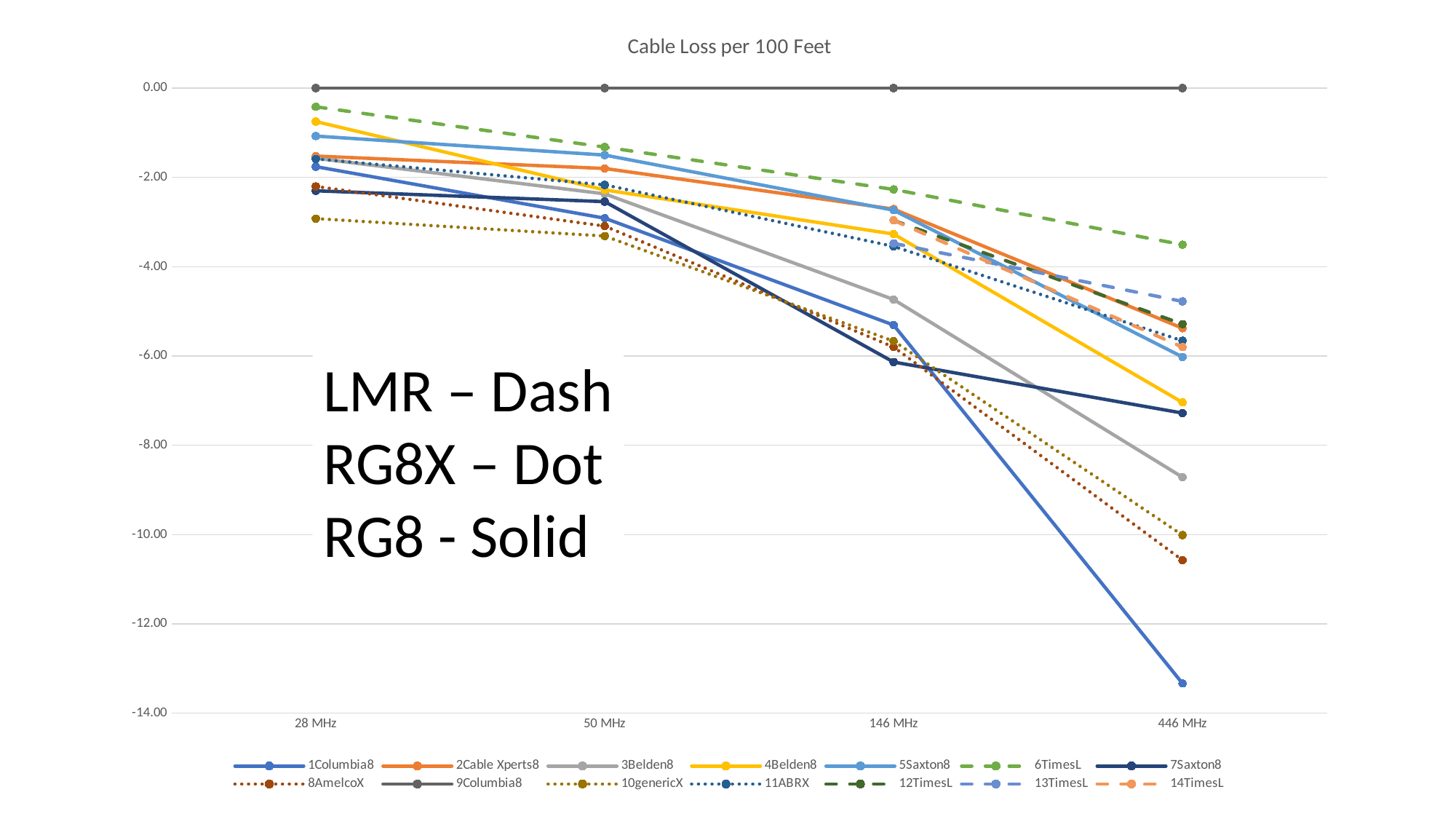
How many frequency categories are shown on the x axis? 4 Which series has the lowest value at 446 MHz? 1Columbia8 What is the title of the chart? Cable Loss per 100 Feet How many series does the legend list? 14 Is the value for 6TimesL at 446 MHz greater or less than -4.00? greater Do the values for 1Columbia8 rise or fall from 28 MHz to 446 MHz? fall What is the value for 9Columbia8 at 446 MHz? 0.00 At 446 MHz, which has the higher value, 1Columbia8 or 3Belden8? 3Belden8 Is the value for 3Belden8 at 446 MHz greater or less than -8.00? less Which series has the highest value at 446 MHz? 9Columbia8 Is the value for 1Columbia8 at 446 MHz greater or less than -12.00? less What kind of chart is shown on the slide? line chart